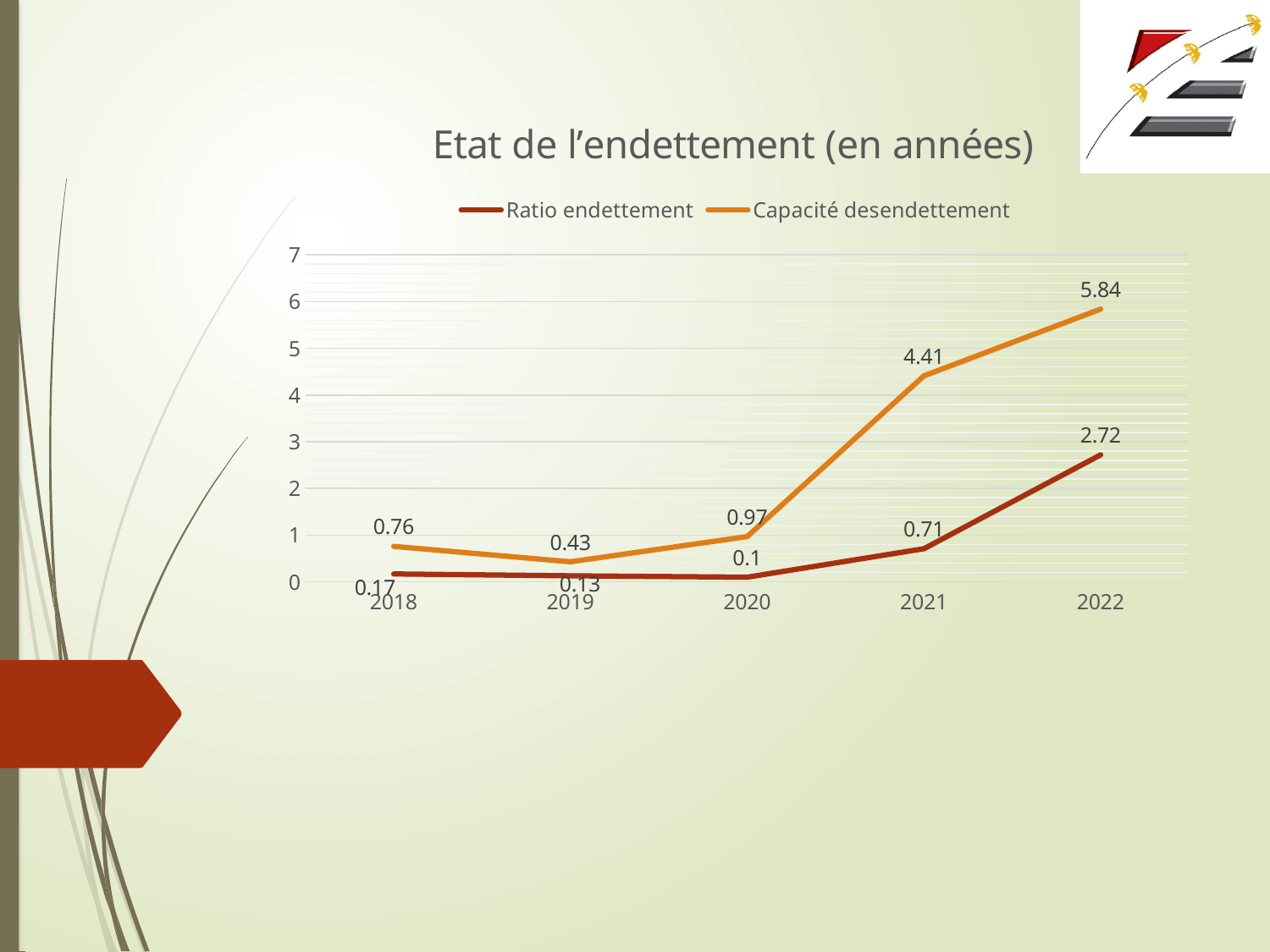
In which year is Ratio endettement lowest? 2020 How many series does the legend list? 2 What type of chart is shown on the slide? line chart What is the difference between Capacité desendettement and Ratio endettement in 2022? 3.12 Which is larger in 2021: Capacité desendettement or Ratio endettement? Capacité desendettement In which year is Capacité desendettement highest? 2022 What is the title of the chart? Etat de l’endettement (en années) What is the value of Capacité desendettement in 2022? 5.84 How many years are shown on the x axis? 5 What is the value of Capacité desendettement in 2019? 0.43 What is the value of Ratio endettement in 2020? 0.1 What is the value of Ratio endettement in 2021? 0.71